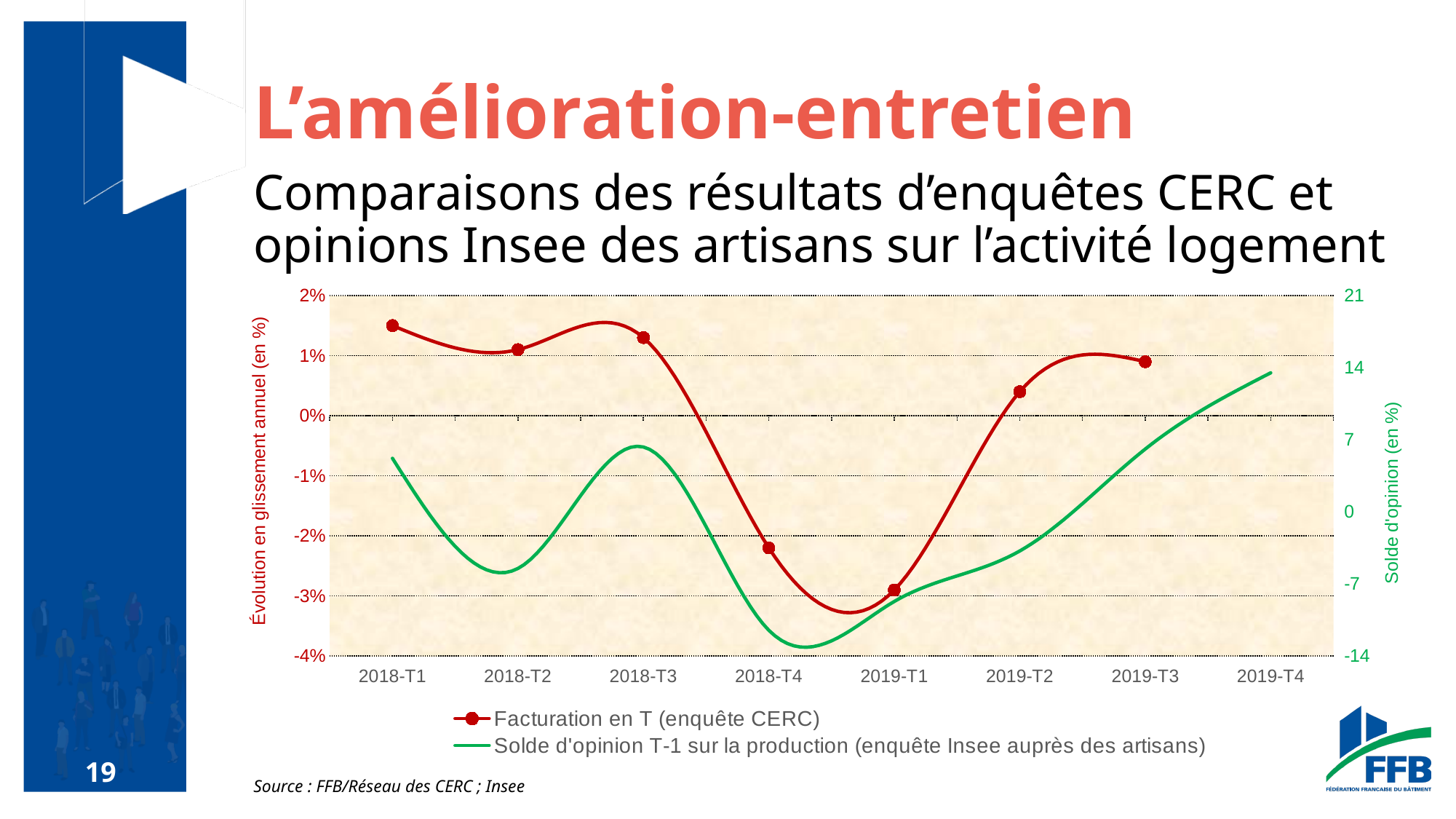
Is the value of 'Facturation en T (enquête CERC)' for 2019-T1 greater or less than -2%? less In which quarter is the 'Solde d'opinion T-1 sur la production' series at its lowest? 2018-T4 In which quarter is the 'Facturation en T (enquête CERC)' series at its highest? 2018-T1 In which quarter is the 'Facturation en T (enquête CERC)' series at its lowest? 2019-T1 How many series does the legend list? 2 How many data points are marked on the 'Facturation en T (enquête CERC)' series? 7 Is the value of 'Solde d'opinion T-1 sur la production' for 2018-T4 greater or less than -7? less Is the value of 'Solde d'opinion T-1 sur la production' for 2019-T4 greater or less than 7? greater What kind of chart is shown on the slide? line chart How many quarters are labelled on the x axis? 8 Which is larger for 'Facturation en T (enquête CERC)': the value for 2018-T1 or the value for 2019-T3? 2018-T1